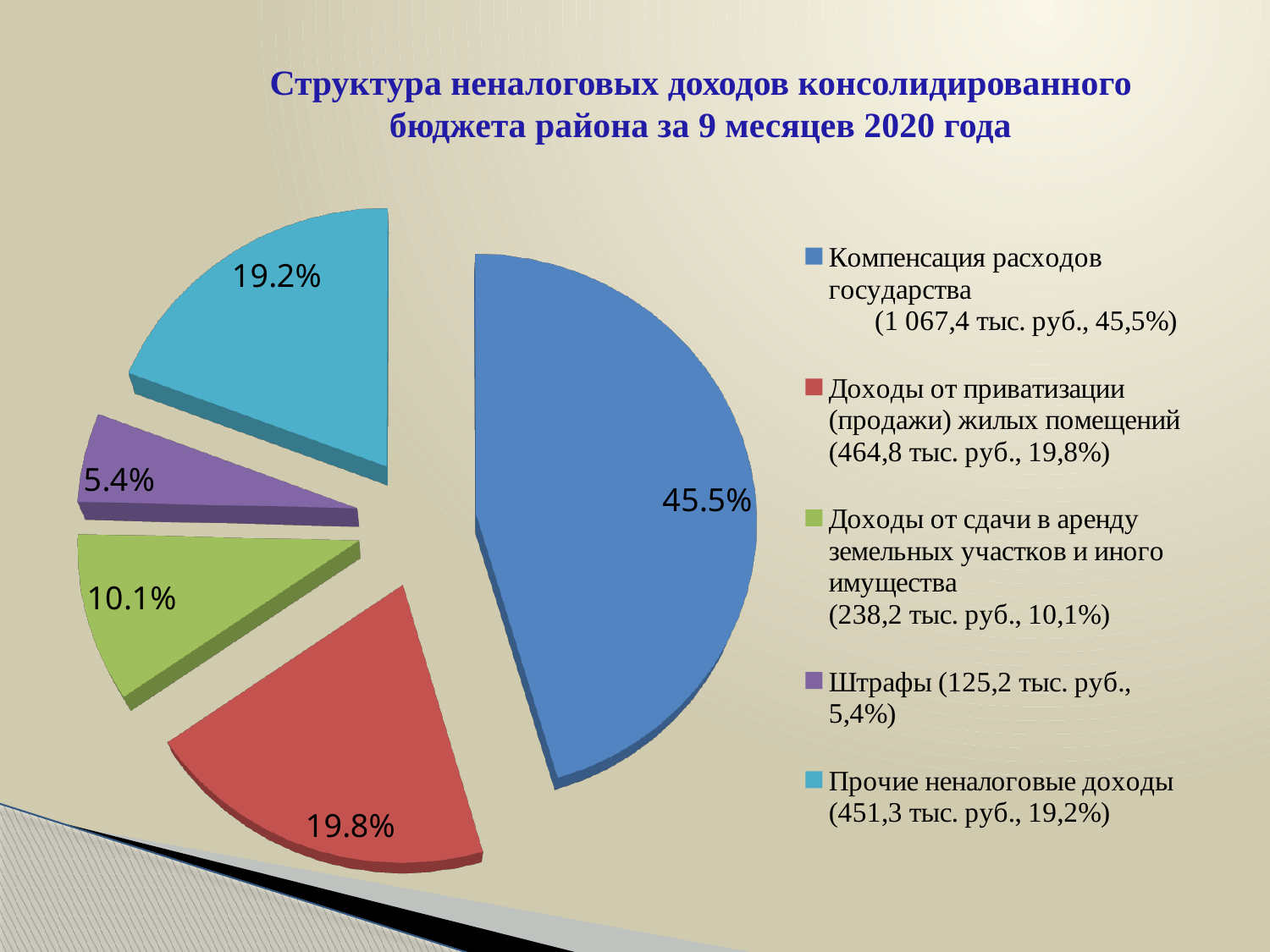
Which category has the largest slice of the pie? Компенсация расходов государства Which is larger: the slice for "Доходы от приватизации (продажи) жилых помещений" or the slice for "Прочие неналоговые доходы"? Доходы от приватизации (продажи) жилых помещений What share of the pie does "Прочие неналоговые доходы" take? 19.2% What share of the pie does "Доходы от приватизации (продажи) жилых помещений" take? 19.8% Which category has the smallest slice of the pie? Штрафы What share of the pie does "Компенсация расходов государства" take? 45.5% What is the difference in percentage points between the slice for "Доходы от приватизации (продажи) жилых помещений" and the slice for "Доходы от сдачи в аренду земельных участков и иного имущества"? 9.7 percentage points How many slices does the pie chart have? 5 What kind of chart is shown on the slide? Pie chart According to the legend, what amount in thousand rubles corresponds to "Штрафы"? 125,2 тыс. руб. What colour is the slice for "Доходы от сдачи в аренду земельных участков и иного имущества"? Green